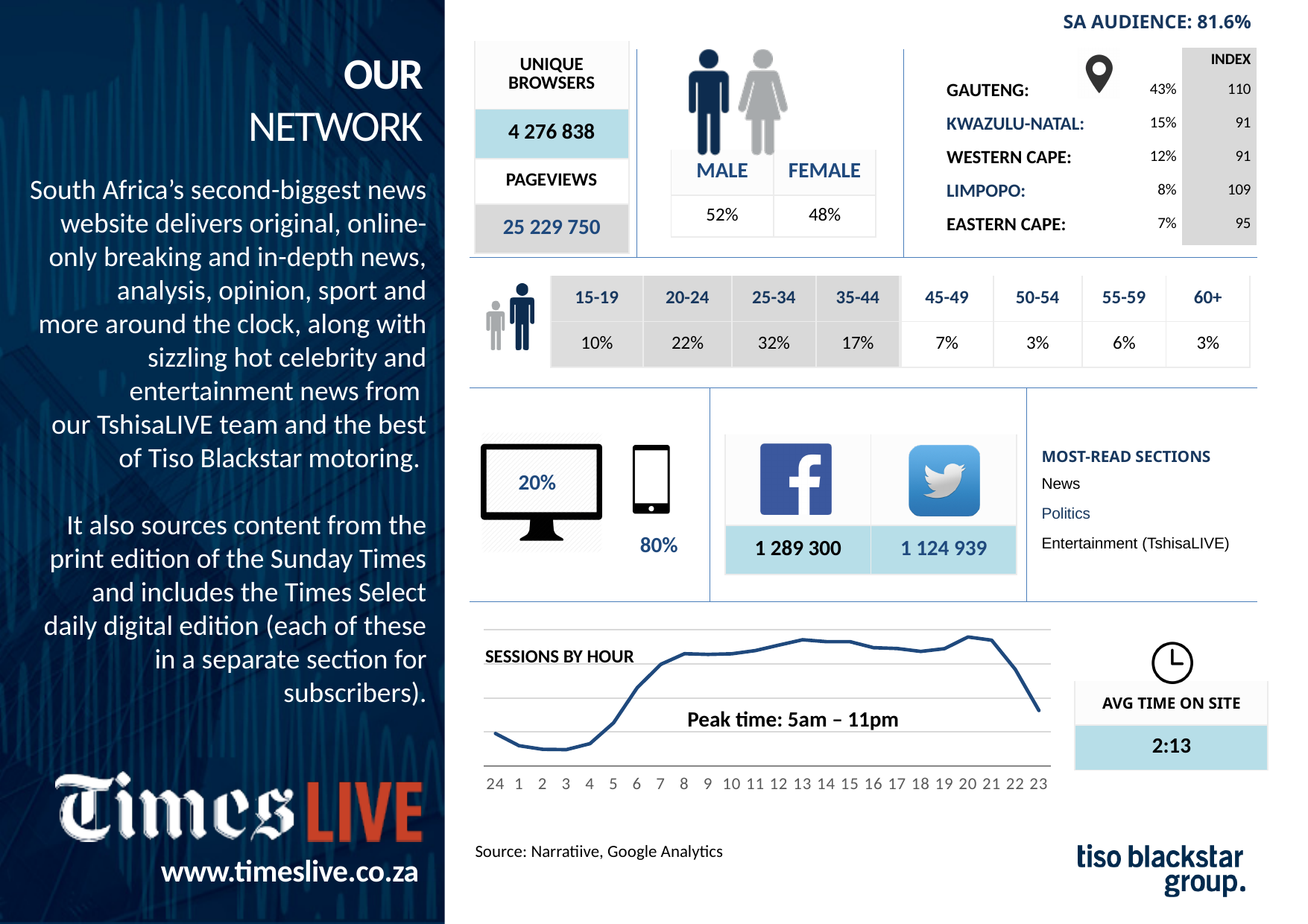
On the 'Sessions by hour' chart, do sessions rise or fall between hour 21 and hour 23? fall What peak time is annotated on the 'Sessions by hour' chart? 5am – 11pm On the 'Sessions by hour' chart, do sessions rise or fall between hour 3 and hour 8? rise On the 'Sessions by hour' chart, are sessions higher at hour 8 or at hour 4? hour 8 How many hour labels are shown on the x axis of the 'Sessions by hour' chart? 24 What kind of chart is the 'Sessions by hour' chart? line chart On the 'Sessions by hour' chart, are sessions higher at hour 13 or at hour 1? hour 13 What is the title of the line chart on the slide? Sessions by hour How many lines are plotted on the 'Sessions by hour' chart? 1 On the 'Sessions by hour' chart, are sessions higher at hour 2 or at hour 23? hour 23